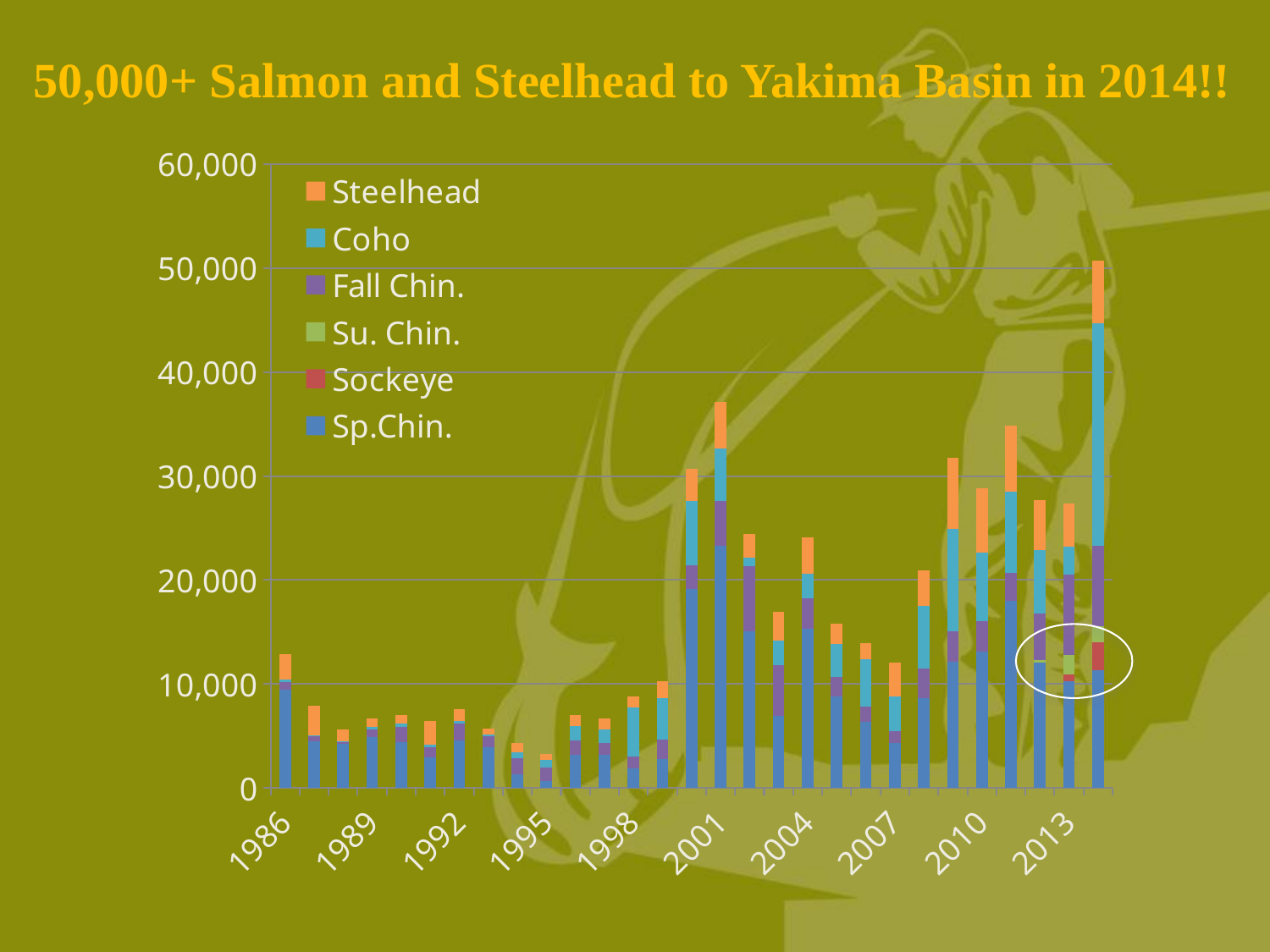
Is the total for 1994 greater or less than 10,000? less How many year labels are printed along the x axis? 10 Is the total for 2002 greater or less than 30,000? less Is the total for 2014 greater or less than 40,000? greater Which series is listed first in the legend? Steelhead Which year has a larger total, 2002 or 2001? 2001 What is the highest value shown on the y axis? 60,000 Which series forms the bottom segment of each stacked bar? Sp.Chin. What kind of chart is shown on the slide? Stacked bar chart Which year has the tallest stacked bar? 2014 Which year has a larger total, 2014 or 2002? 2014 How many series does the legend list? 6